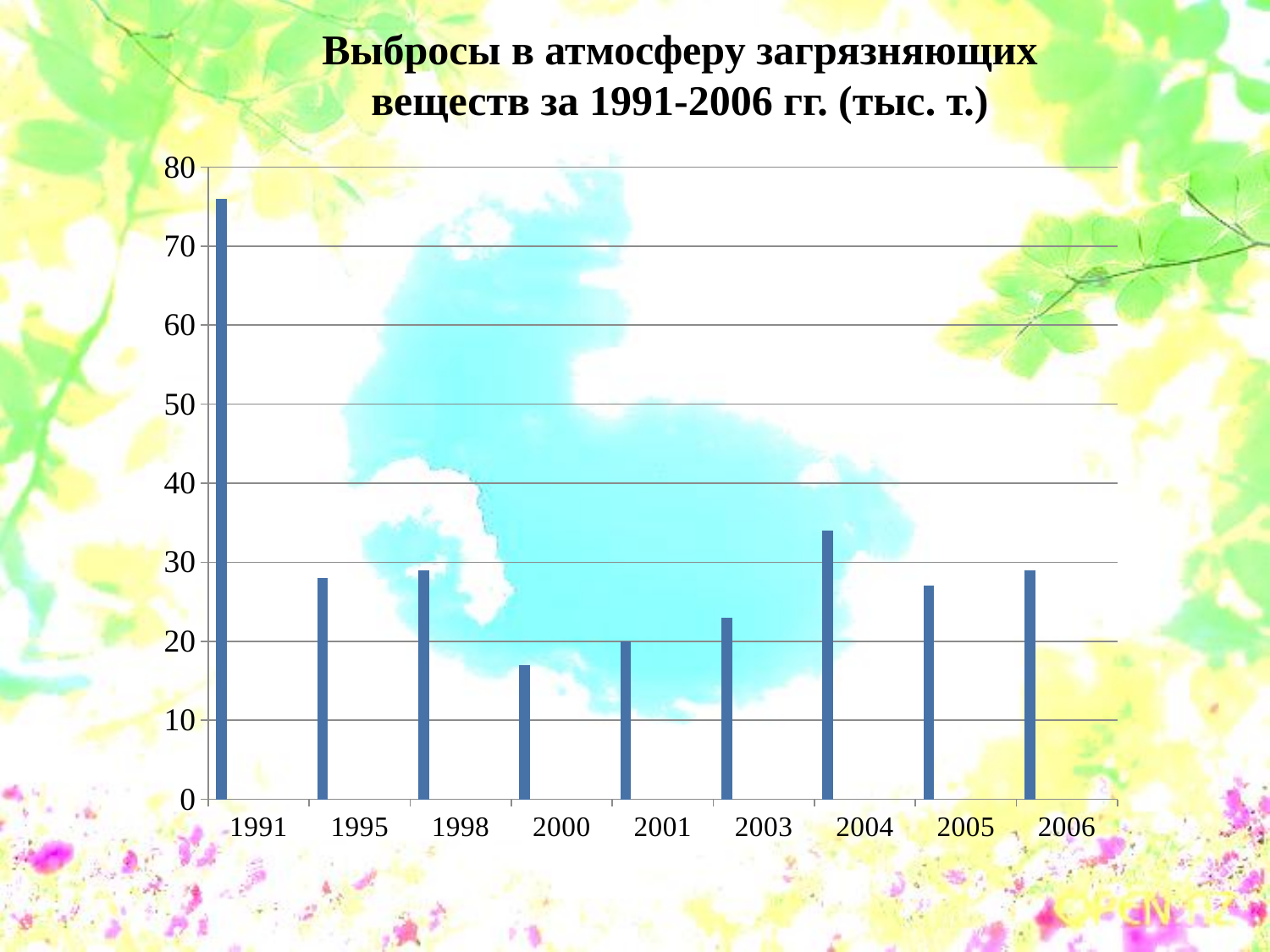
Is the value for 2003 greater or less than 20? greater Is the value for 1991 greater or less than 70? greater Which year has the lowest emissions value in the chart? 2000 What kind of chart is shown on the slide? bar chart Which year has the highest emissions value in the chart? 1991 What is the title of the chart? Выбросы в атмосферу загрязняющих веществ за 1991-2006 гг. (тыс. т.) Which is larger, the value for 2004 or the value for 2005? 2004 Is the value for 2000 greater or less than 20? less Which is larger, the value for 1991 or the value for 2004? 1991 How many years are shown on the x axis of the chart? 9